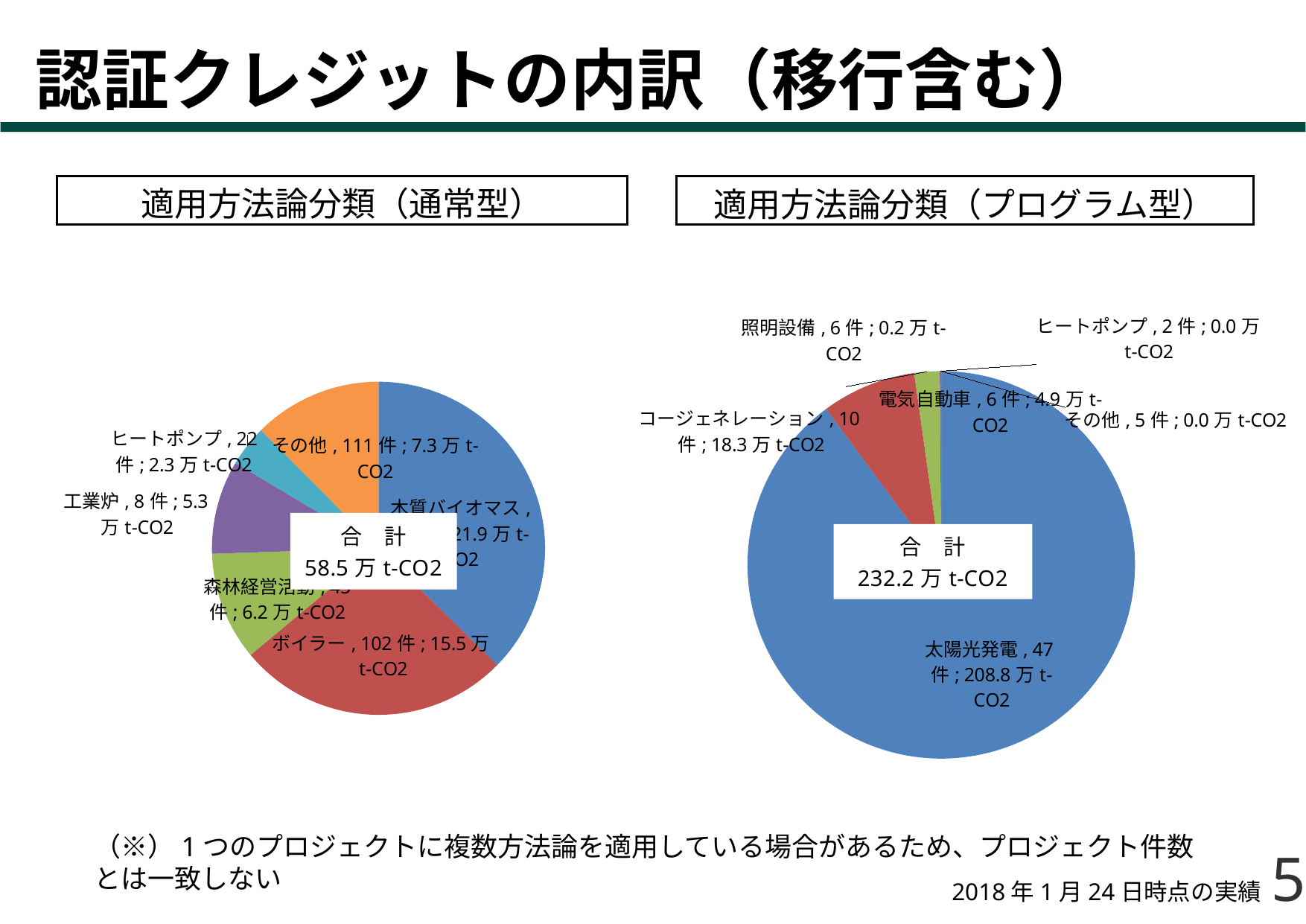
In the 適用方法論分類（通常型） chart, which category has the smallest credit amount? ヒートポンプ In the 適用方法論分類（プログラム型） chart, which is larger, コージェネレーション or 電気自動車? コージェネレーション In the 適用方法論分類（プログラム型） chart, what is the total shown in the centre? 232.2 万 t-CO2 What type of chart is used for 適用方法論分類（通常型）? pie chart In the 適用方法論分類（プログラム型） chart, how many 件 are listed for 照明設備? 6 件 In the 適用方法論分類（通常型） chart, what is the total shown in the centre? 58.5 万 t-CO2 In the 適用方法論分類（プログラム型） chart, what is the credit amount for 太陽光発電? 208.8 万 t-CO2 In the 適用方法論分類（通常型） chart, which category has the largest credit amount? 木質バイオマス In the 適用方法論分類（通常型） chart, how many slices does the pie have? 6 In the 適用方法論分類（通常型） chart, how many 件 are listed for ボイラー? 102 件 In the 適用方法論分類（通常型） chart, what is the difference in credit amount between 木質バイオマス and ボイラー? 6.4 万 t-CO2 In the 適用方法論分類（通常型） chart, what is the credit amount for ボイラー? 15.5 万 t-CO2